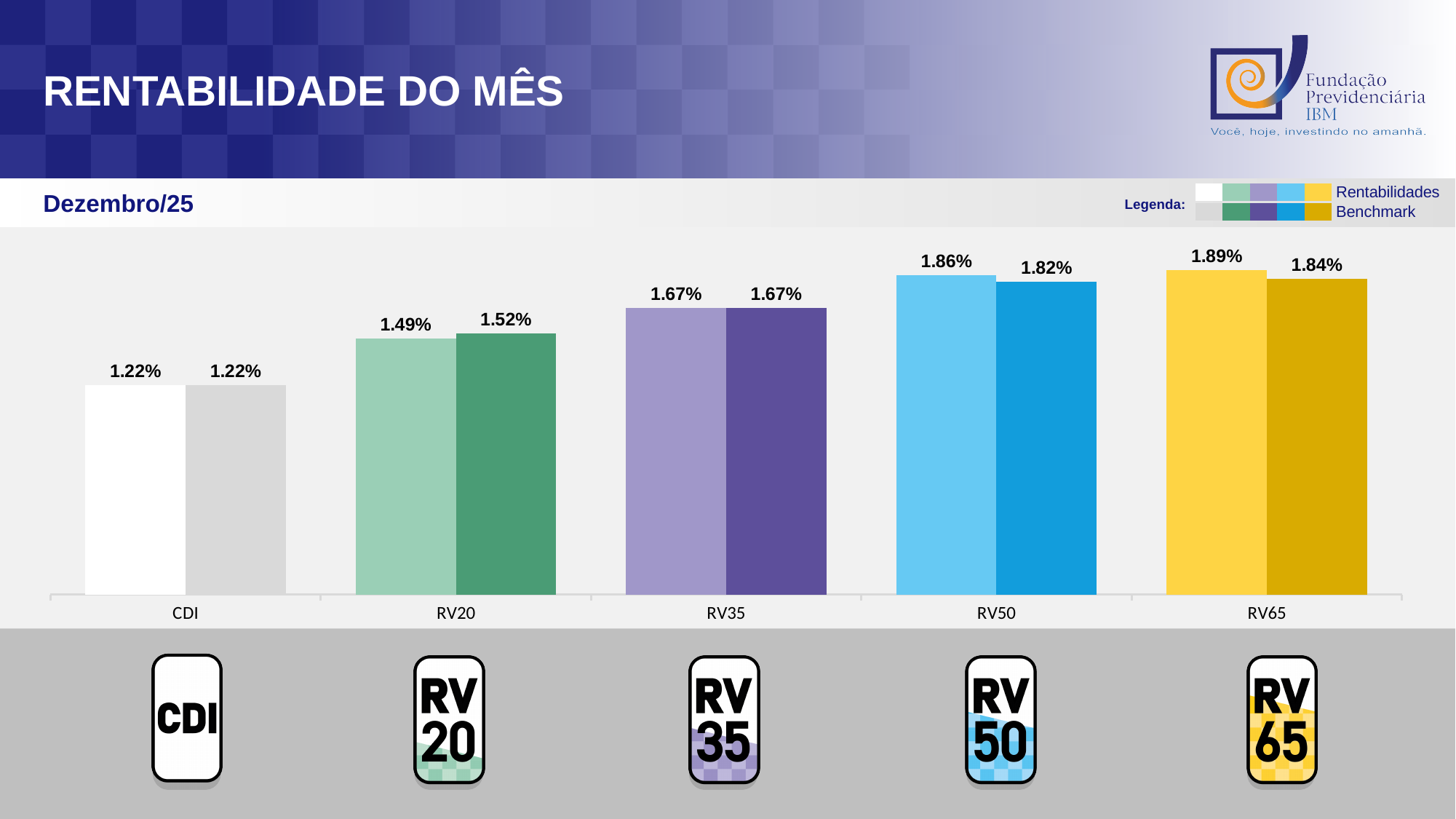
For RV20, which is larger: the Rentabilidades value or the Benchmark value? Benchmark What is the difference between the Rentabilidades and Benchmark values for RV65? 0.05% What is the Benchmark value for RV50? 1.82% How many series does the legend list? 2 What is the Rentabilidades value for CDI? 1.22% What kind of chart is shown on the slide? Bar chart Do the Rentabilidades values rise or fall from CDI to RV65 along the x axis? Rise What is the Rentabilidades value for RV20? 1.49% Which category has the lowest Benchmark value? CDI Which category has the highest Rentabilidades value? RV65 What is the difference between the Benchmark values for RV20 and RV35? 0.15% How many categories are shown on the x axis of the chart? 5